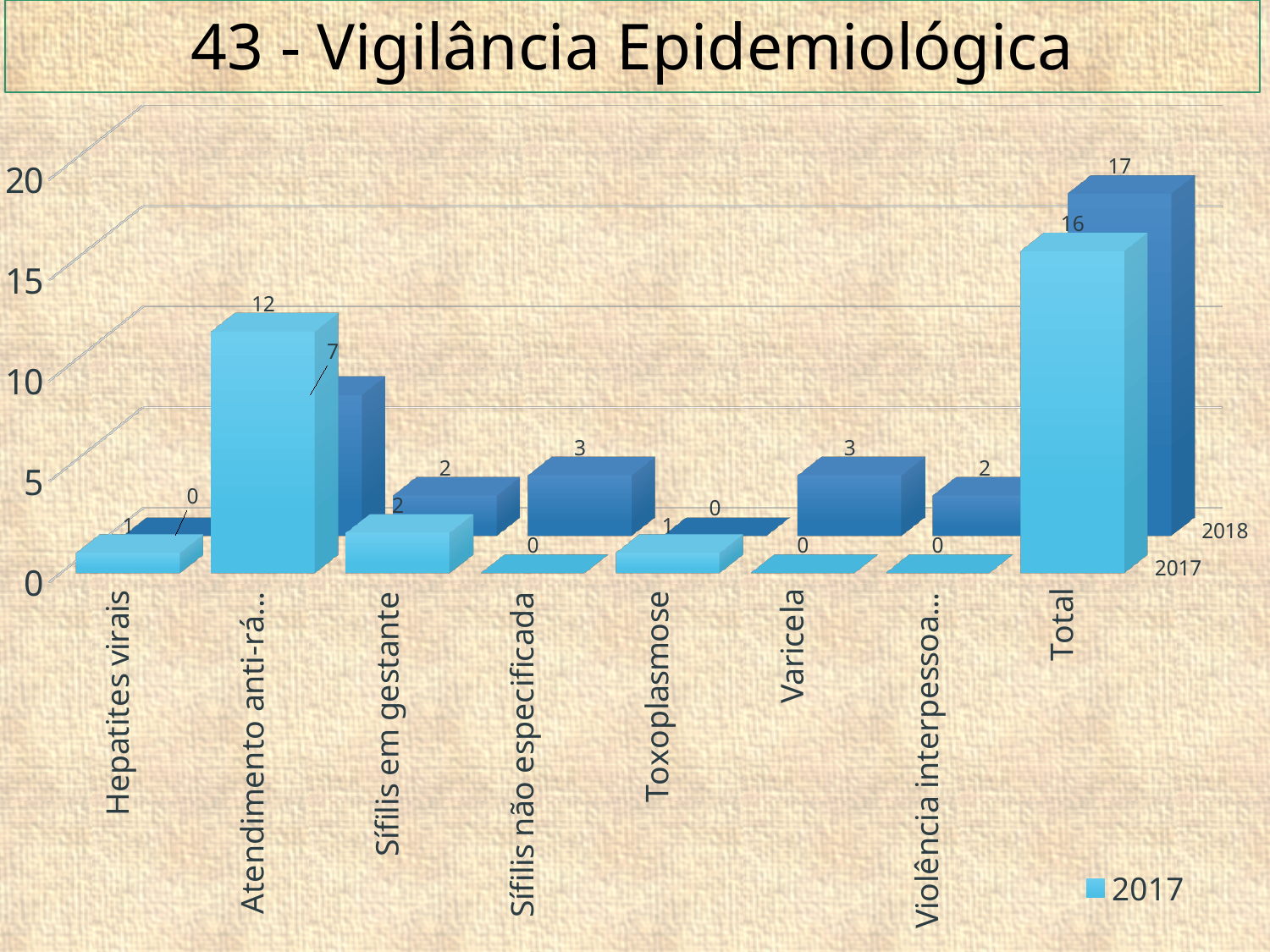
What kind of chart is shown on the slide? bar chart What is the 2017 value for Hepatites virais? 1 What is the 2018 value for Varicela? 3 Excluding Total, which category has the highest 2017 value? Atendimento anti-rá... What is the 2018 value for Total? 17 How many categories are shown on the x axis? 8 What is the 2017 value for Sífilis em gestante? 2 What is the difference between the 2017 and 2018 values for Atendimento anti-rá...? 5 What is the title of the slide? 43 - Vigilância Epidemiológica Is the 2017 value for Total greater or less than 15? greater Which is larger for Total, the 2017 value or the 2018 value? 2018 What is the 2017 value for Total? 16